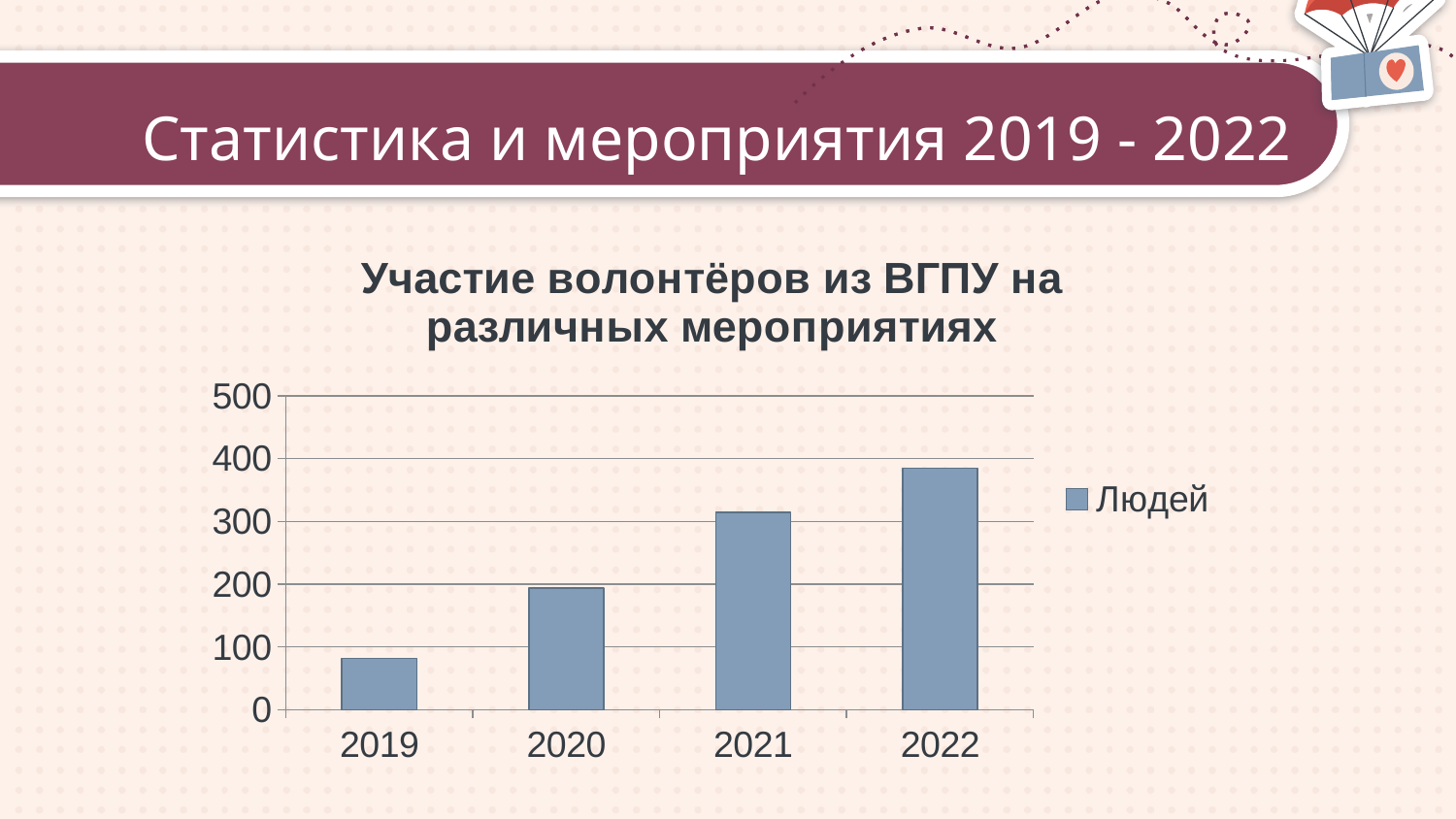
How many years are shown on the x axis? 4 Which year has the highest value? 2022 What type of chart is shown on the slide? bar chart Which year has the lowest value? 2019 Which is larger, the value for 2020 or the value for 2021? 2021 How many series does the legend list? 1 Is the value for 2021 greater or less than 300? greater What is the title of the chart? Участие волонтёров из ВГПУ на различных мероприятиях Do the values rise or fall from 2019 to 2022? rise What is the name of the series shown in the legend? Людей Is the value for 2022 greater or less than 400? less Is the value for 2019 greater or less than 100? less